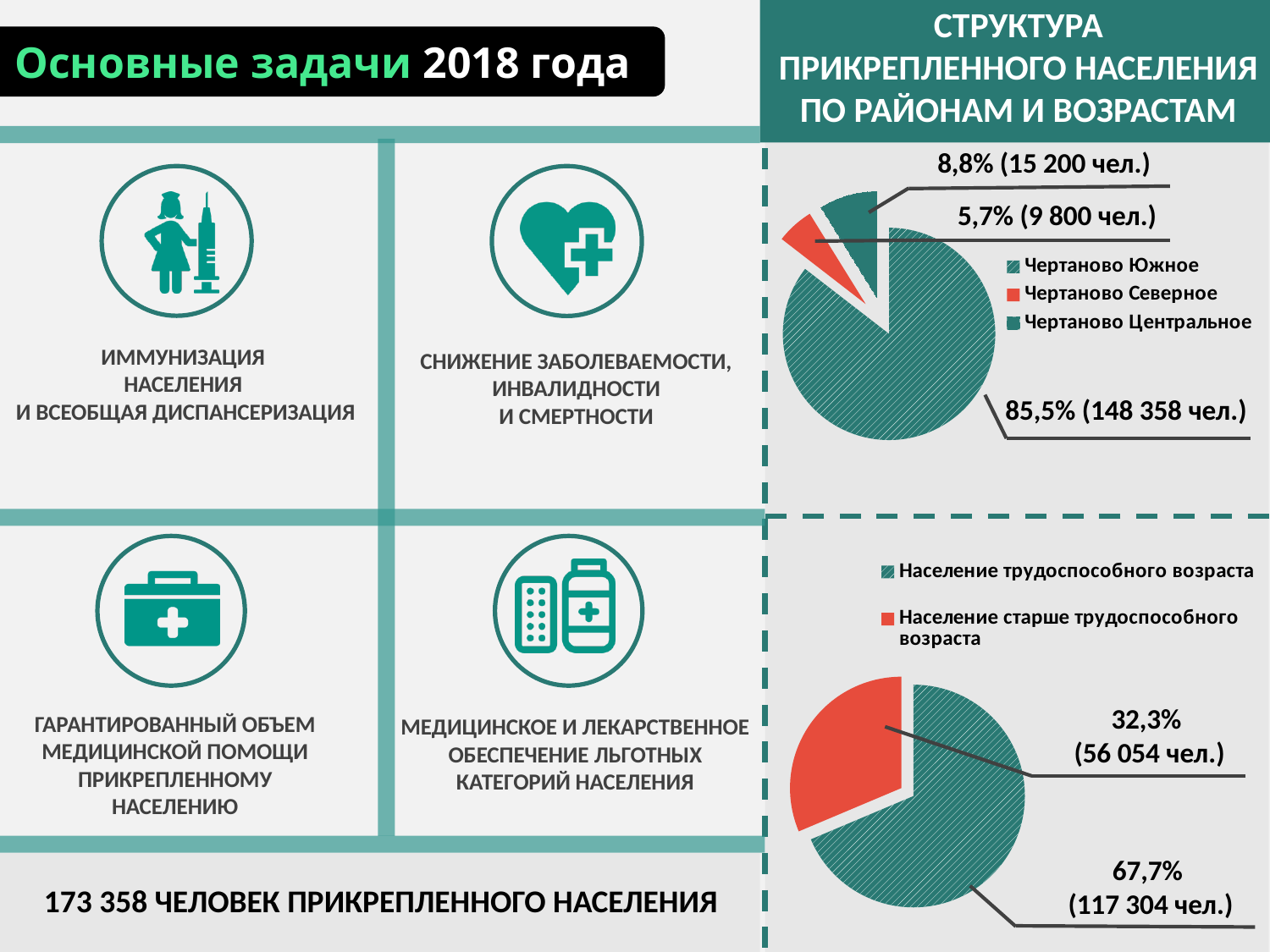
In the bottom pie chart (by age), what colour is the slice for the population older than working age? red In the top pie chart (by district), what share does Чертаново Южное have? 85,5% In the top pie chart (by district), what share does Чертаново Центральное have? 8,8% In the top pie chart (by district), which district has the largest share? Чертаново Южное In the top pie chart (by district), how many people are in Чертаново Северное? 9 800 чел. In the bottom pie chart (by age), what share is the population of working age (Население трудоспособного возраста)? 67,7% In the top pie chart (by district), what is the difference in percentage points between Чертаново Центральное and Чертаново Северное? 3,1 What kind of chart is the top chart on the right side of the slide? pie chart In the bottom pie chart (by age), how many people are older than working age (Население старше трудоспособного возраста)? 56 054 чел. In the top pie chart (by district), how many districts are shown in the legend? 3 In the top pie chart (by district), which district has the smallest share? Чертаново Северное In the bottom pie chart (by age), which group is larger: working age or older than working age? Население трудоспособного возраста